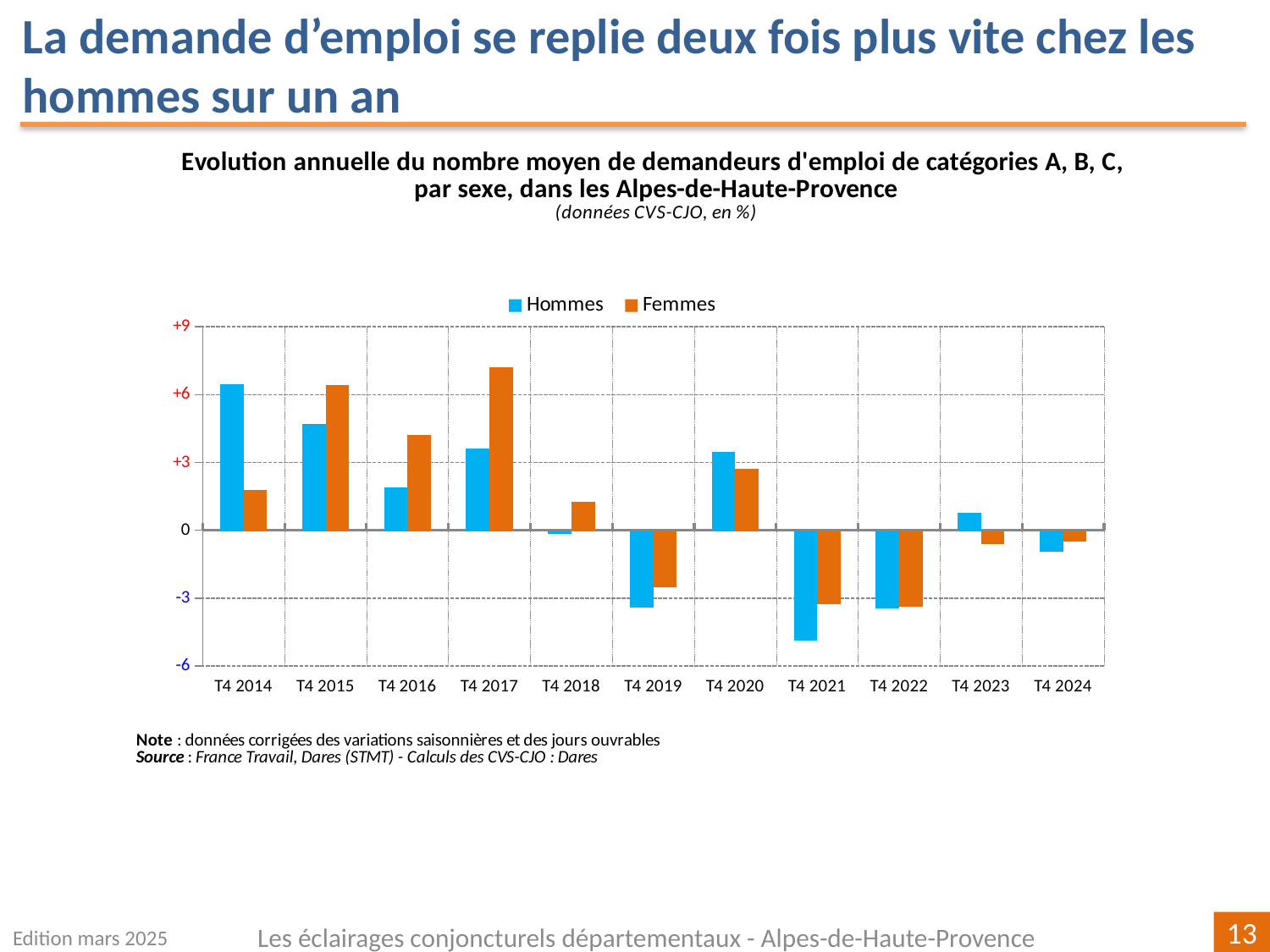
Is the Hommes value for T4 2015 greater or less than +3? greater How many series does the legend list? 2 How many quarters (categories) are shown on the x axis? 11 In which quarter is the Hommes value the lowest? T4 2021 In T4 2014, which series has the larger value, Hommes or Femmes? Hommes Is the Femmes value for T4 2017 greater or less than +6? greater In T4 2017, which series has the larger value, Hommes or Femmes? Femmes Is the Femmes value for T4 2014 greater or less than +3? less In which quarter is the Femmes value the highest? T4 2017 Which colour represents the Hommes series in the chart? blue What kind of chart is shown on the slide? bar chart